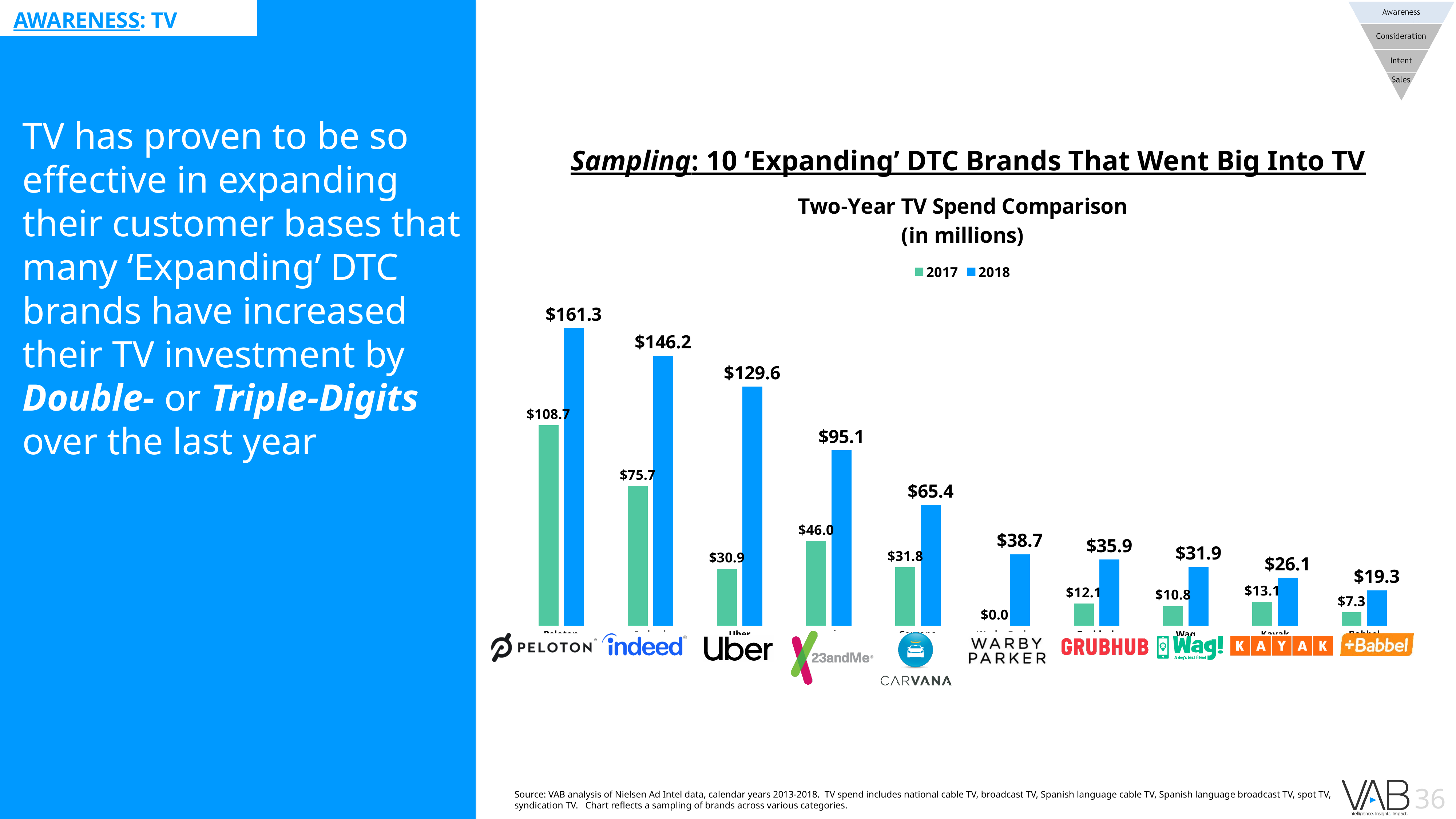
By how much did Indeed's TV spend increase from 2017 to 2018 according to the chart? $70.5 Which brand had the highest 2018 TV spend in the chart? Peloton What was Warby Parker's 2017 TV spend according to the chart? $0.0 How many series does the legend of the chart list? 2 How many brands are shown in the Two-Year TV Spend Comparison chart? 10 Which brand spent more on TV in 2018, Carvana or 23andMe? 23andMe Which colour represents 2018 in the chart's legend? Blue Which brand had the lowest 2018 TV spend in the chart? Babbel What was Peloton's 2018 TV spend in the Two-Year TV Spend Comparison chart? $161.3 Do the 2018 TV spend values rise or fall moving from left to right across the brands in the chart? Fall What kind of chart is the Two-Year TV Spend Comparison? Bar chart What was Uber's 2017 TV spend according to the chart? $30.9